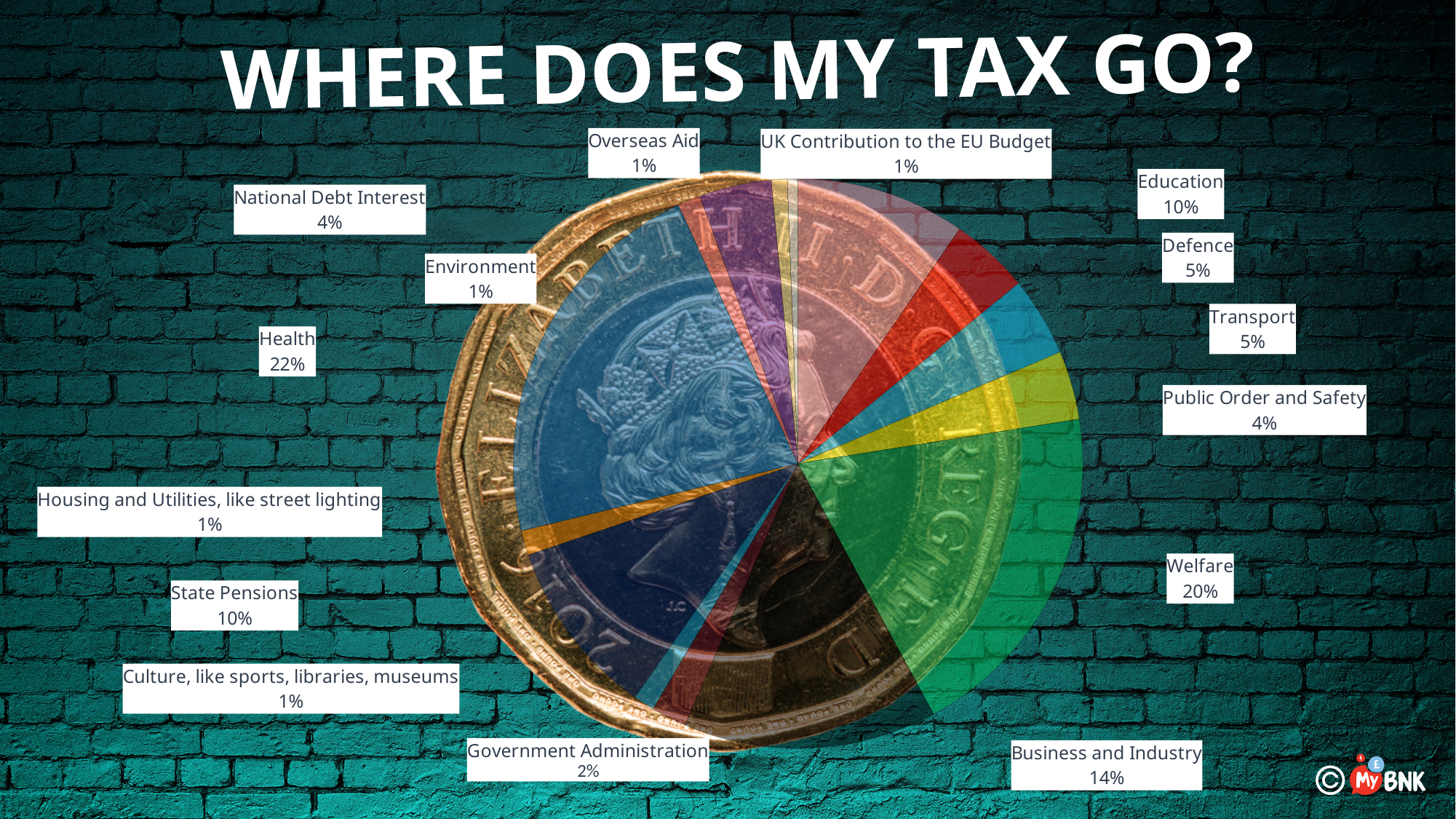
How many categories are shown in the pie chart? 15 What kind of chart is shown on the slide? pie chart What percentage of tax goes to Health? 22% What percentage of tax goes to Government Administration? 2% What percentage of tax goes to National Debt Interest? 4% What share of the pie does State Pensions represent? 10% Which receives a larger share of tax, Welfare or Business and Industry? Welfare What is the title of the slide? WHERE DOES MY TAX GO? What is the difference between the shares for Health and Welfare? 2% What percentage of tax goes to Welfare? 20% What percentage of tax goes to Business and Industry? 14% Which category receives the largest share of tax? Health